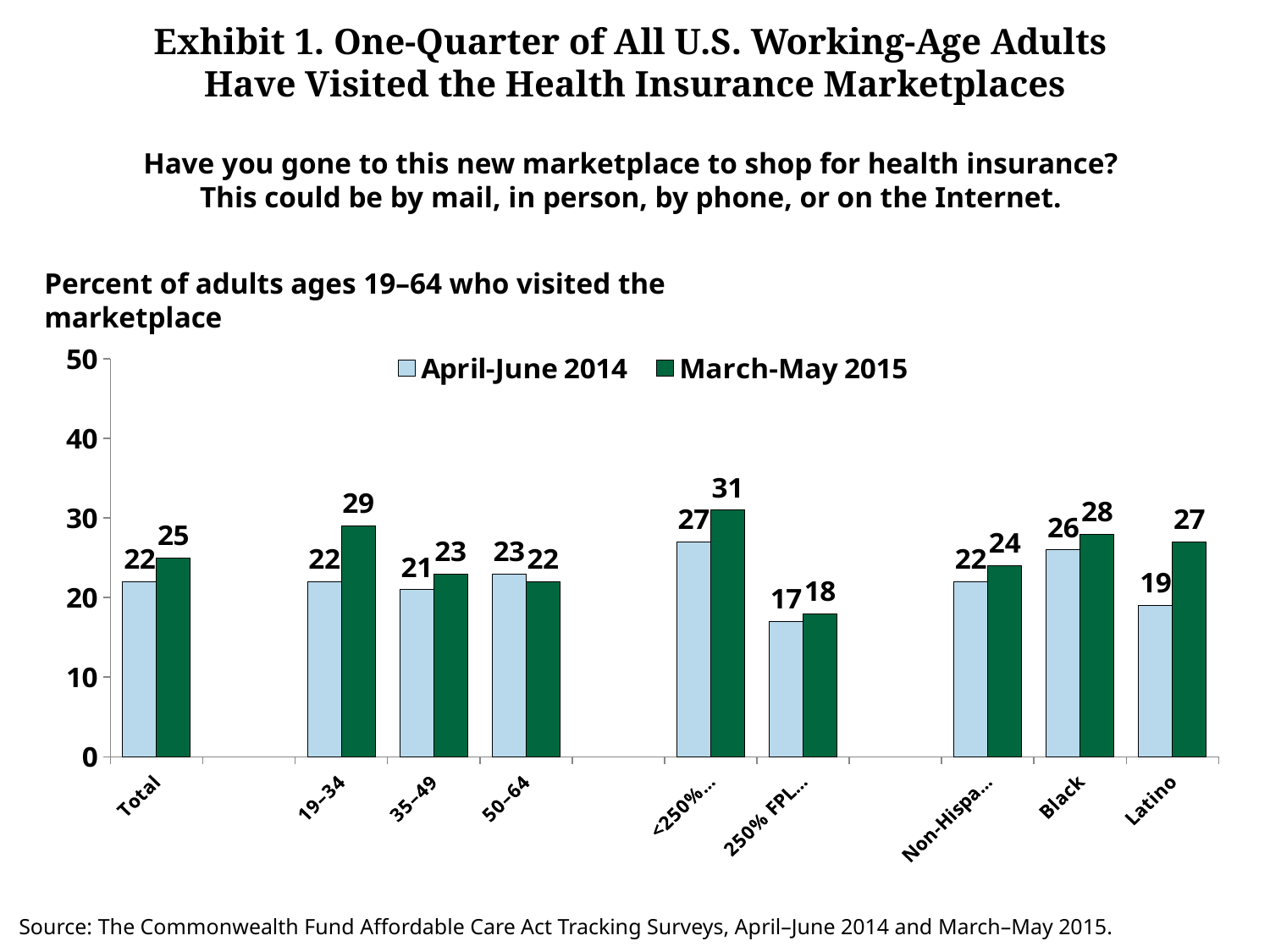
How many series does the legend list? 2 What is the difference between the March-May 2015 and April-June 2014 values for the 19–34 age group? 7 What is the value for the 19–34 age group in the April-June 2014 series? 22 Among the age groups 19–34, 35–49 and 50–64, which has the highest March-May 2015 value? 19–34 What is the value for Total in the March-May 2015 series? 25 What is the value for Black in the April-June 2014 series? 26 How many categories are shown on the x axis of the chart? 9 Among Total, Black and Latino, which has the lowest April-June 2014 value? Latino For the 50–64 age group, which series has the larger value, April-June 2014 or March-May 2015? April-June 2014 What kind of chart is shown on the slide? Bar chart What is the value for Latino in the March-May 2015 series? 27 By how much did the value for Latino increase from April-June 2014 to March-May 2015? 8